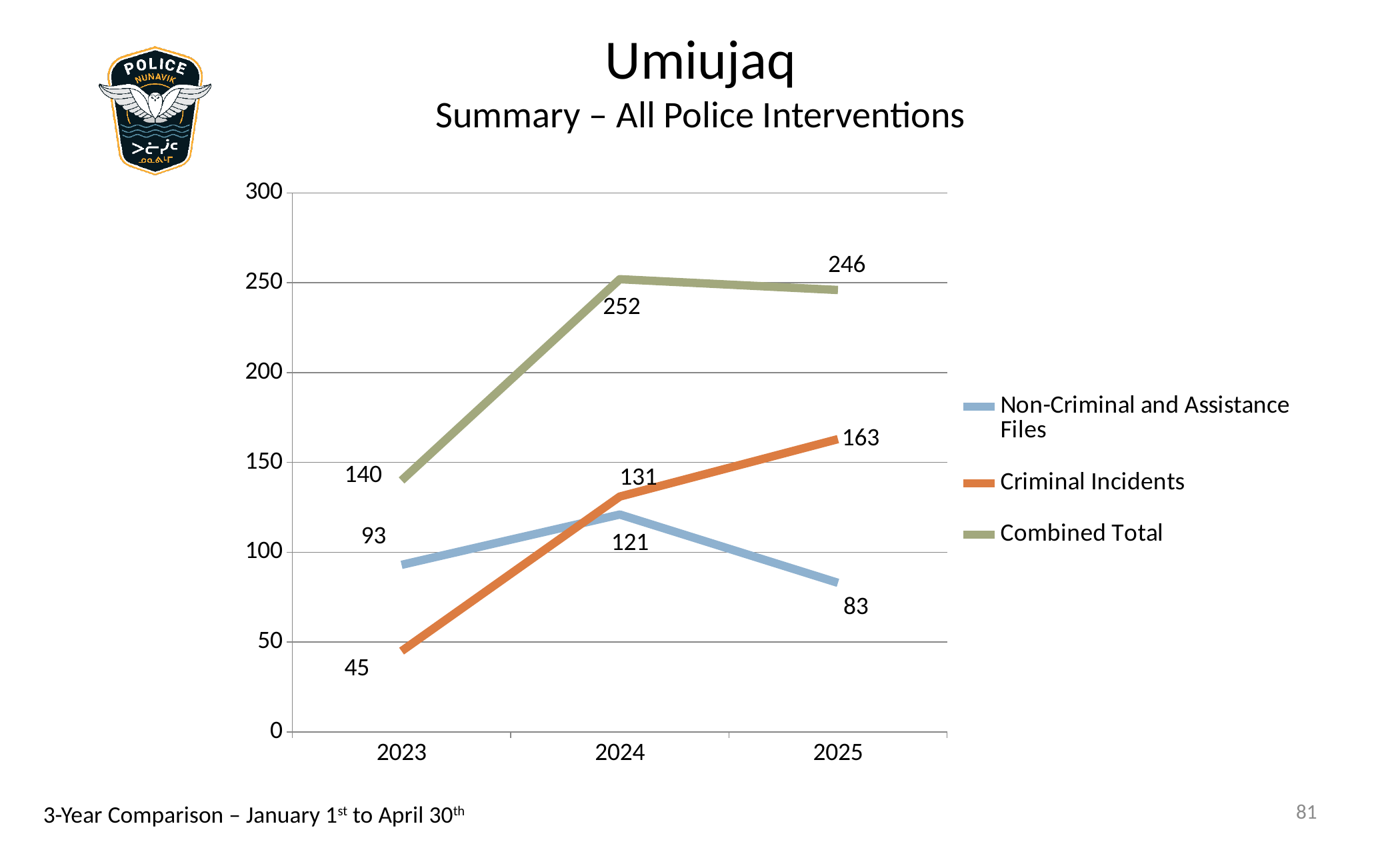
Which is larger in 2024: Criminal Incidents or Non-Criminal and Assistance Files? Criminal Incidents What is the title of the slide? Umiujaq Summary – All Police Interventions Do the Criminal Incidents values rise or fall from 2023 to 2025? Rise How many series does the legend list? 3 In which year is the Combined Total highest? 2024 What is the value for Non-Criminal and Assistance Files in 2023? 93 What is the Combined Total for 2024? 252 What kind of chart is shown on the slide? Line chart What is the difference between Criminal Incidents in 2025 and in 2023? 118 What is the value for Criminal Incidents in 2025? 163 How many years are shown on the x axis? 3 In which year is the Criminal Incidents value lowest? 2023